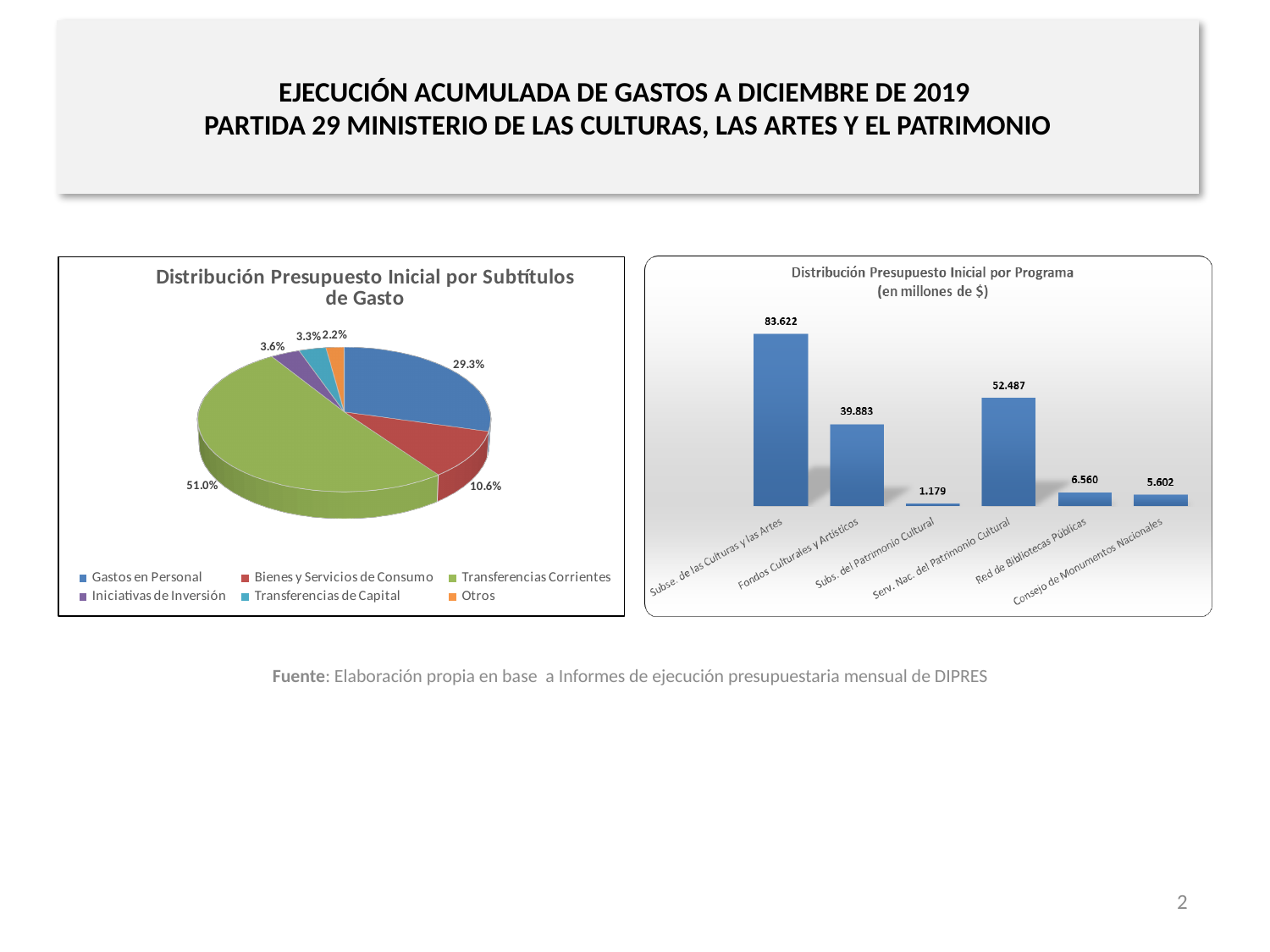
What type of chart is the 'Distribución Presupuesto Inicial por Programa' chart? Bar chart In the 'Distribución Presupuesto Inicial por Subtítulos de Gasto' pie chart, which category has the smallest slice? Otros In the 'Distribución Presupuesto Inicial por Subtítulos de Gasto' pie chart, what share does Transferencias Corrientes have? 51.0% In the 'Distribución Presupuesto Inicial por Programa' chart, which program has the lowest value? Subs. del Patrimonio Cultural How many programs are shown in the 'Distribución Presupuesto Inicial por Programa' chart? 6 In the 'Distribución Presupuesto Inicial por Programa' chart, what is the difference between Subse. de las Culturas y las Artes and Serv. Nac. del Patrimonio Cultural? 31.135 In the 'Distribución Presupuesto Inicial por Programa' chart, which is larger: Red de Bibliotecas Públicas or Consejo de Monumentos Nacionales? Red de Bibliotecas Públicas In the 'Distribución Presupuesto Inicial por Programa' chart, what is the value for Subse. de las Culturas y las Artes? 83.622 In the 'Distribución Presupuesto Inicial por Programa' chart, which program has the highest value? Subse. de las Culturas y las Artes How many categories does the legend of the 'Distribución Presupuesto Inicial por Subtítulos de Gasto' pie chart list? 6 In the 'Distribución Presupuesto Inicial por Subtítulos de Gasto' pie chart, what share does Gastos en Personal have? 29.3% In the 'Distribución Presupuesto Inicial por Programa' chart, what is the value for Serv. Nac. del Patrimonio Cultural? 52.487